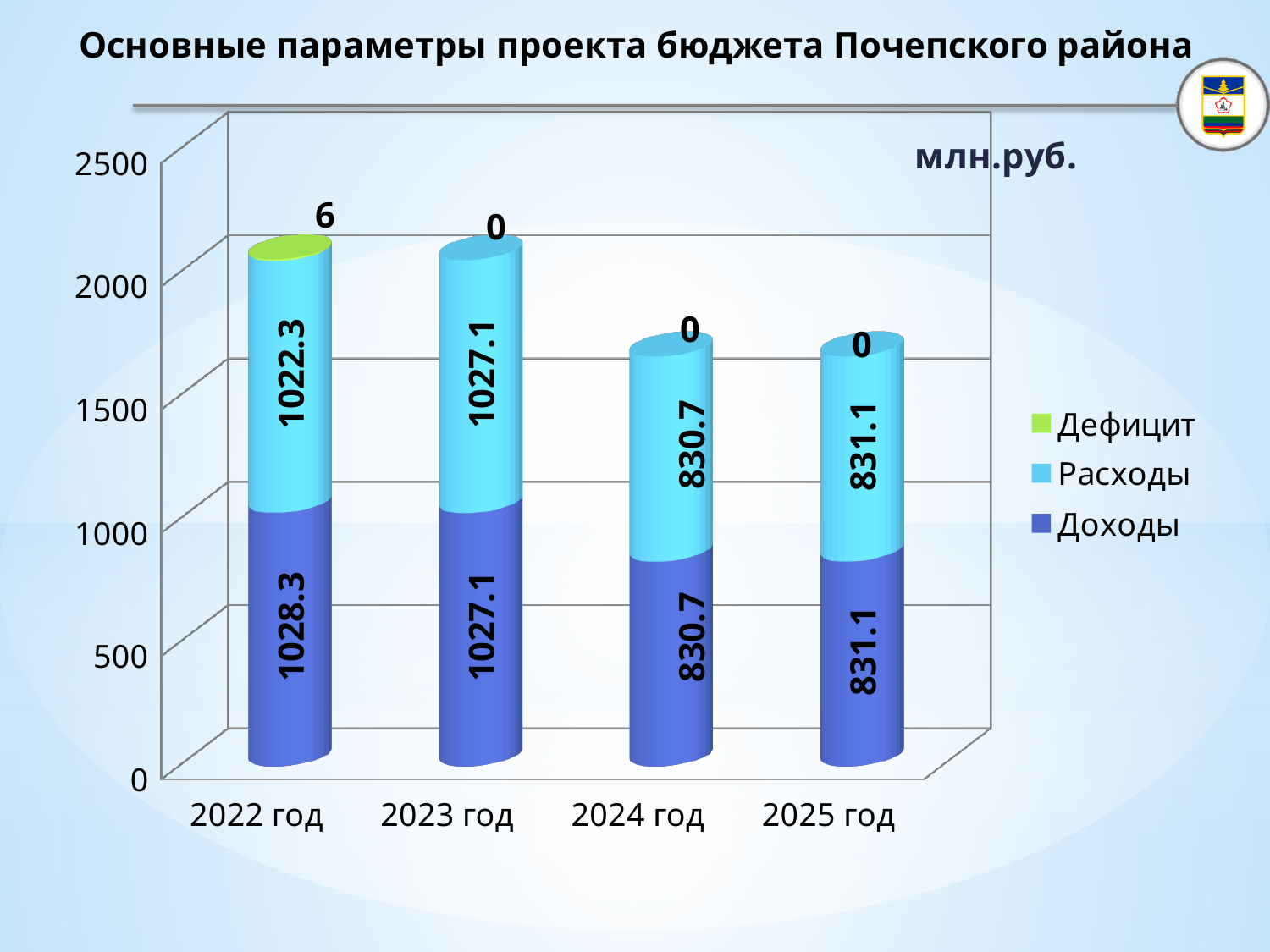
What kind of chart is shown on the slide? Stacked bar chart How many series does the legend list? 3 How many years are shown on the x axis? 4 What is the value of Расходы for 2025 год? 831.1 What unit is indicated for the values on the chart? млн.руб. Which is larger: Доходы for 2022 год or Доходы for 2025 год? Доходы for 2022 год What is the total of the stacked bar for 2024 год? 1661.4 What is the difference between Доходы for 2023 год and Доходы for 2024 год? 196.4 What is the value of Дефицит for 2022 год? 6 Which year has the lowest value of Доходы? 2024 год What is the value of Расходы for 2024 год? 830.7 What is the value of Доходы for 2022 год? 1028.3